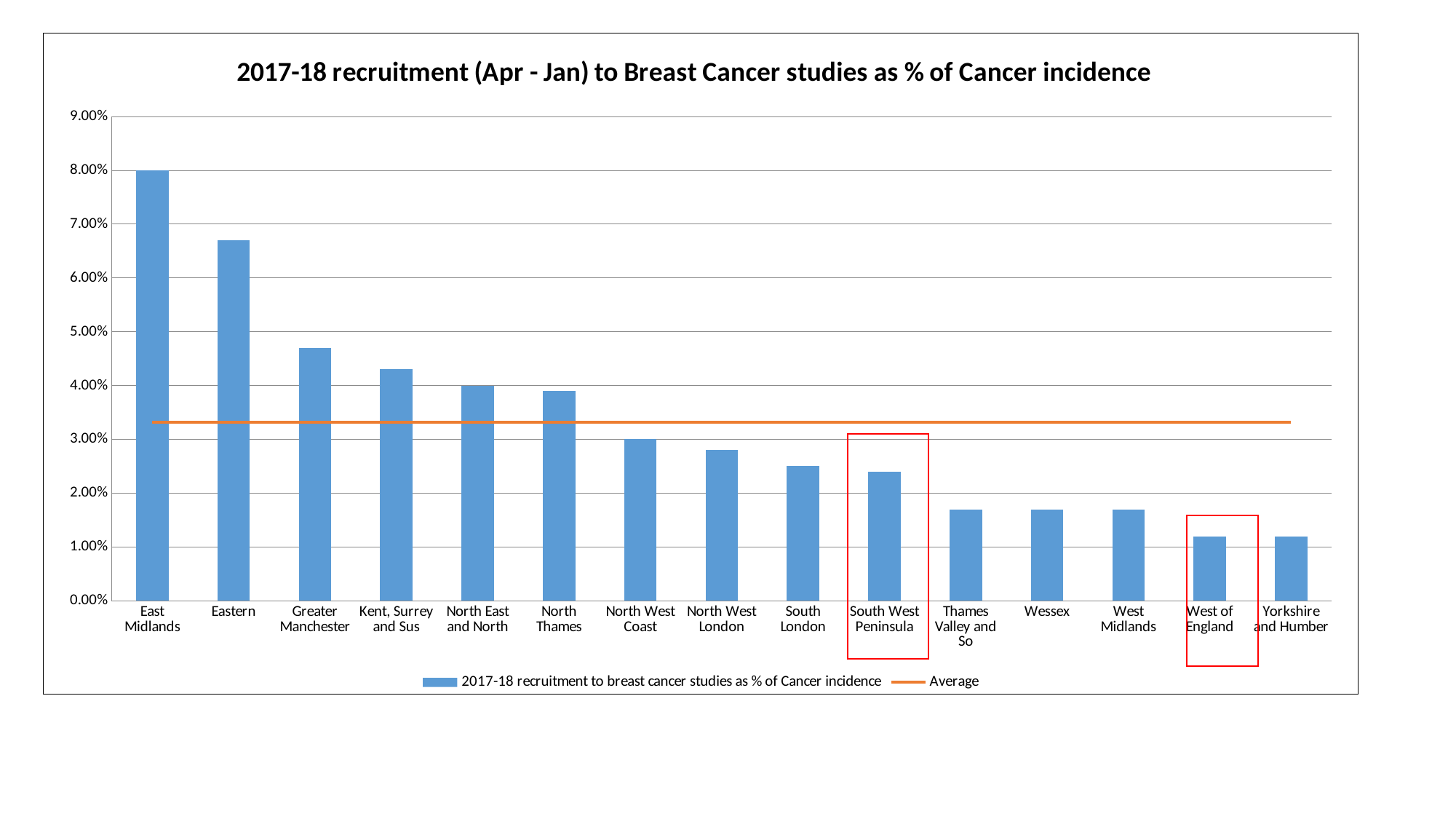
Is the value for Eastern greater or less than 6.00%? greater Do the bar values rise or fall moving from left to right along the x axis? Fall Which region has the highest recruitment as % of cancer incidence? East Midlands What is the recruitment as % of cancer incidence for East Midlands? 8.00% Is the value for South London greater or less than 2.00%? greater How many series does the legend list? 2 How many regions are shown on the x axis of the chart? 15 Is the value for Wessex greater or less than 2.00%? less What is the title of the chart? 2017-18 recruitment (Apr - Jan) to Breast Cancer studies as % of Cancer incidence Which is larger, the value for Eastern or the value for Greater Manchester? Eastern What does the orange horizontal line on the chart represent? Average What type of chart is shown on the slide? Combination bar and line chart (bars with an average line)